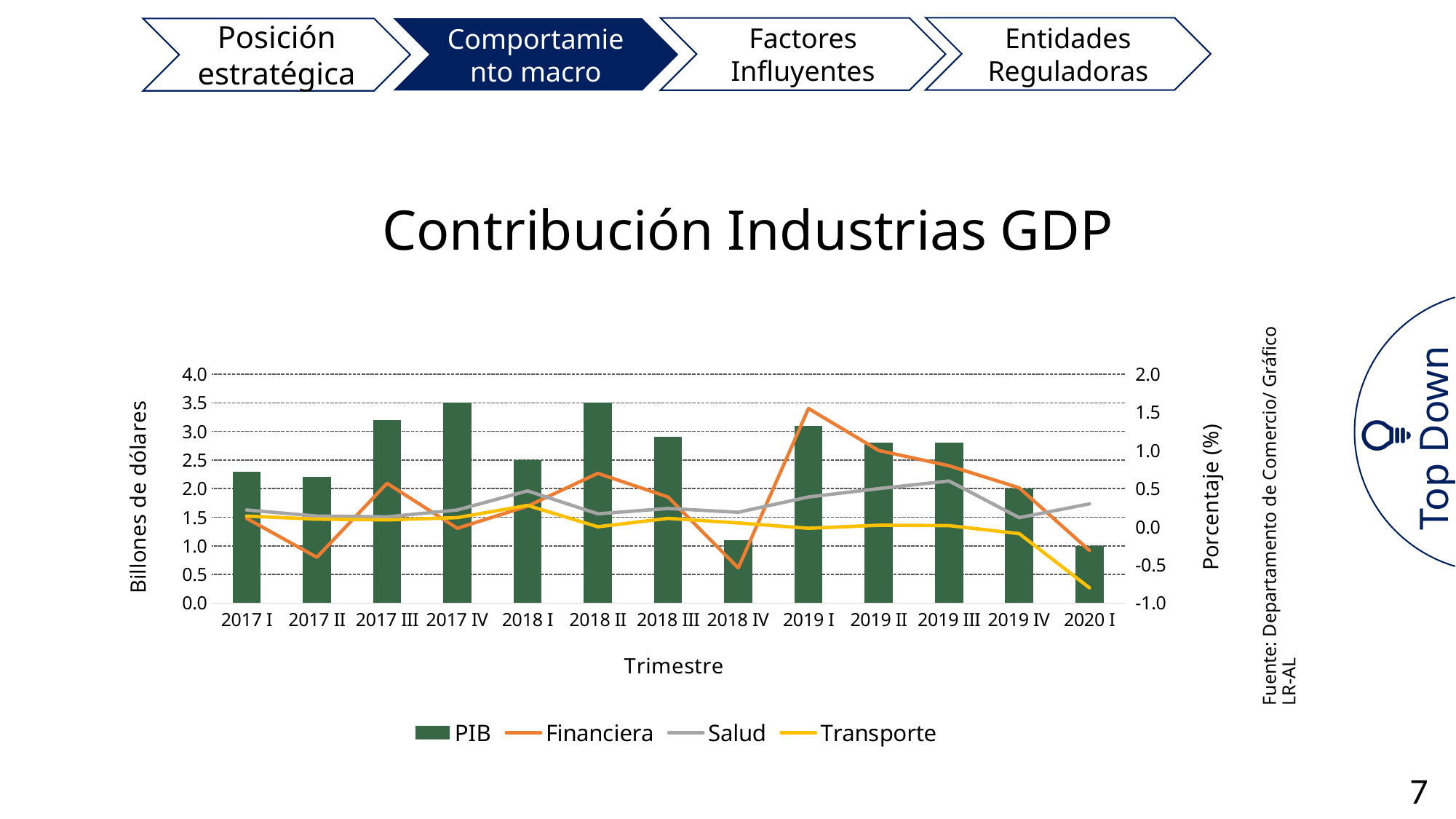
In which quarter does the Financiera line reach its highest value? 2019 I What kind of chart is shown on the slide? Combined bar and line chart What is the PIB value for 2018 I in billones de dólares? 2.5 How many quarters are shown on the x axis? 13 Which has a larger PIB value, 2017 III or 2018 I? 2017 III What is the title of the chart? Contribución Industrias GDP What is the label of the left vertical axis? Billones de dólares Is the PIB value for 2017 III greater or less than 3.0? greater Does the Transporte line rise or fall from 2019 III to 2020 I? fall What is the PIB value for 2020 I in billones de dólares? 1.0 Is the PIB value for 2018 IV greater or less than 1.5? less How many series does the legend list? 4